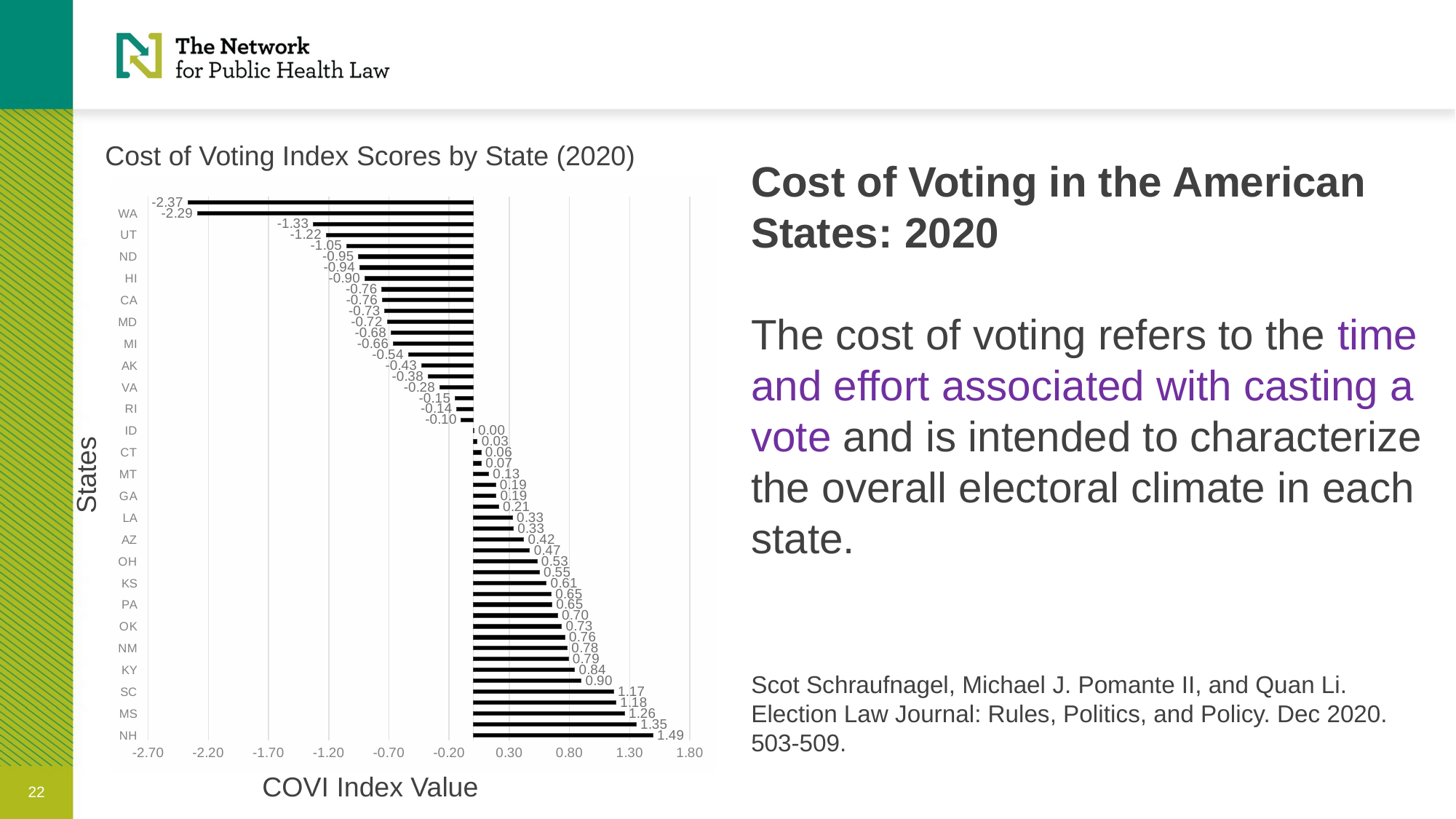
What is the lowest COVI Index Value shown in the chart? -2.37 Which is larger, the value of the top bar (-2.37) or the value of the bottom bar (1.49)? 1.49 What is the title of the chart? Cost of Voting Index Scores by State (2020) What is the difference between the highest value (1.49) and the lowest value (-2.37) in the chart? 3.86 What is the highest COVI Index Value shown in the chart? 1.49 What kind of chart is shown on the slide? bar chart What is the COVI Index Value for NH, the state at the bottom of the chart? 1.49 How many bars in the chart have a value greater than 1.00? 5 Which state label appears at the top of the chart's y axis? WA Do the bar values increase or decrease going from the top of the chart to the bottom? increase Is the value for NH greater or less than 1.30? greater What is the label of the x axis of the chart? COVI Index Value